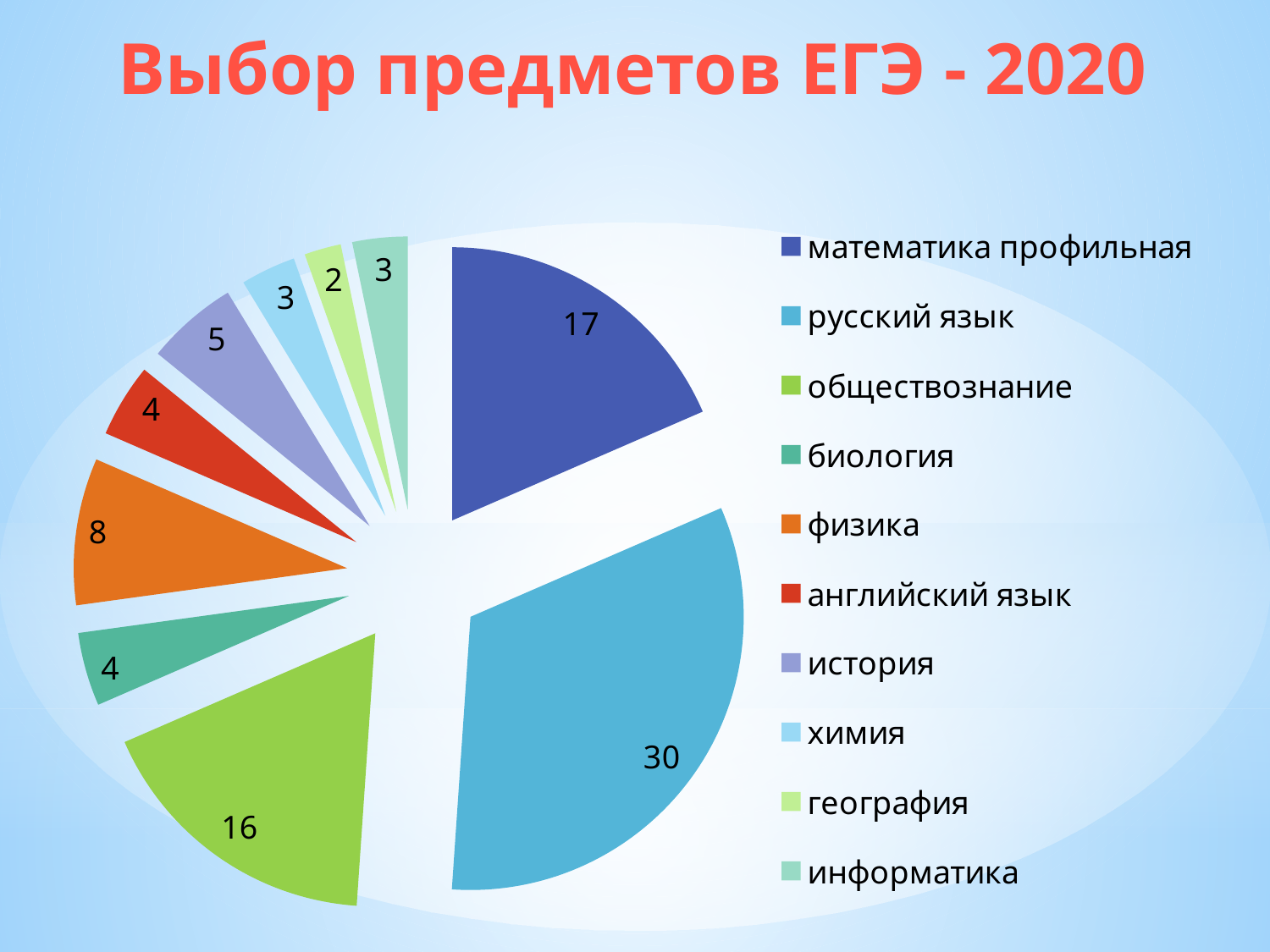
What is the value for физика? 8 Which subject has the largest slice of the pie? русский язык How many subjects (categories) does the pie chart show? 10 What is the difference between the values for русский язык and обществознание? 14 Which is larger, the value for история or the value for химия? история What is the value for русский язык? 30 What type of chart is shown on the slide? pie chart What is the value for математика профильная? 17 What is the title of the chart? Выбор предметов ЕГЭ - 2020 What is the value for география? 2 Which subject has the smallest slice of the pie? география What is the total of all the values shown in the pie chart? 92